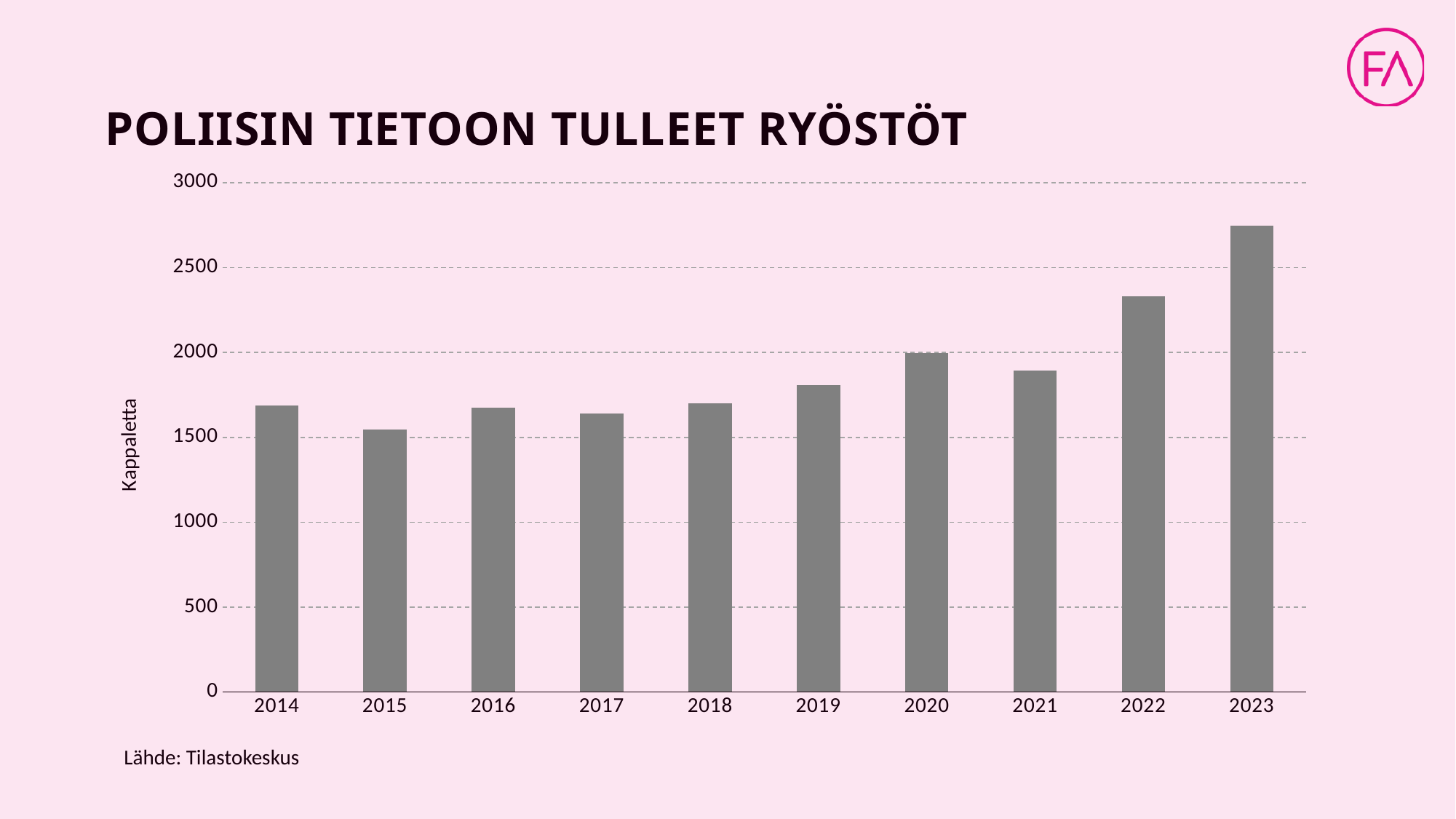
Is the value for 2023 greater or less than 2500? greater What is the label on the vertical axis of the chart? Kappaletta Which year has the highest number of robberies reported to the police? 2023 Which is larger, the value for 2015 or the value for 2020? 2020 How many years are shown on the x axis of the chart? 10 Is the value for 2019 greater or less than 1500? greater Which is larger, the value for 2022 or the value for 2021? 2022 Do the values generally rise or fall from 2014 to 2023? Rise What kind of chart is shown on the slide? Bar chart Is the value for 2022 greater or less than 2500? less Which year has the lowest number of robberies reported to the police? 2015